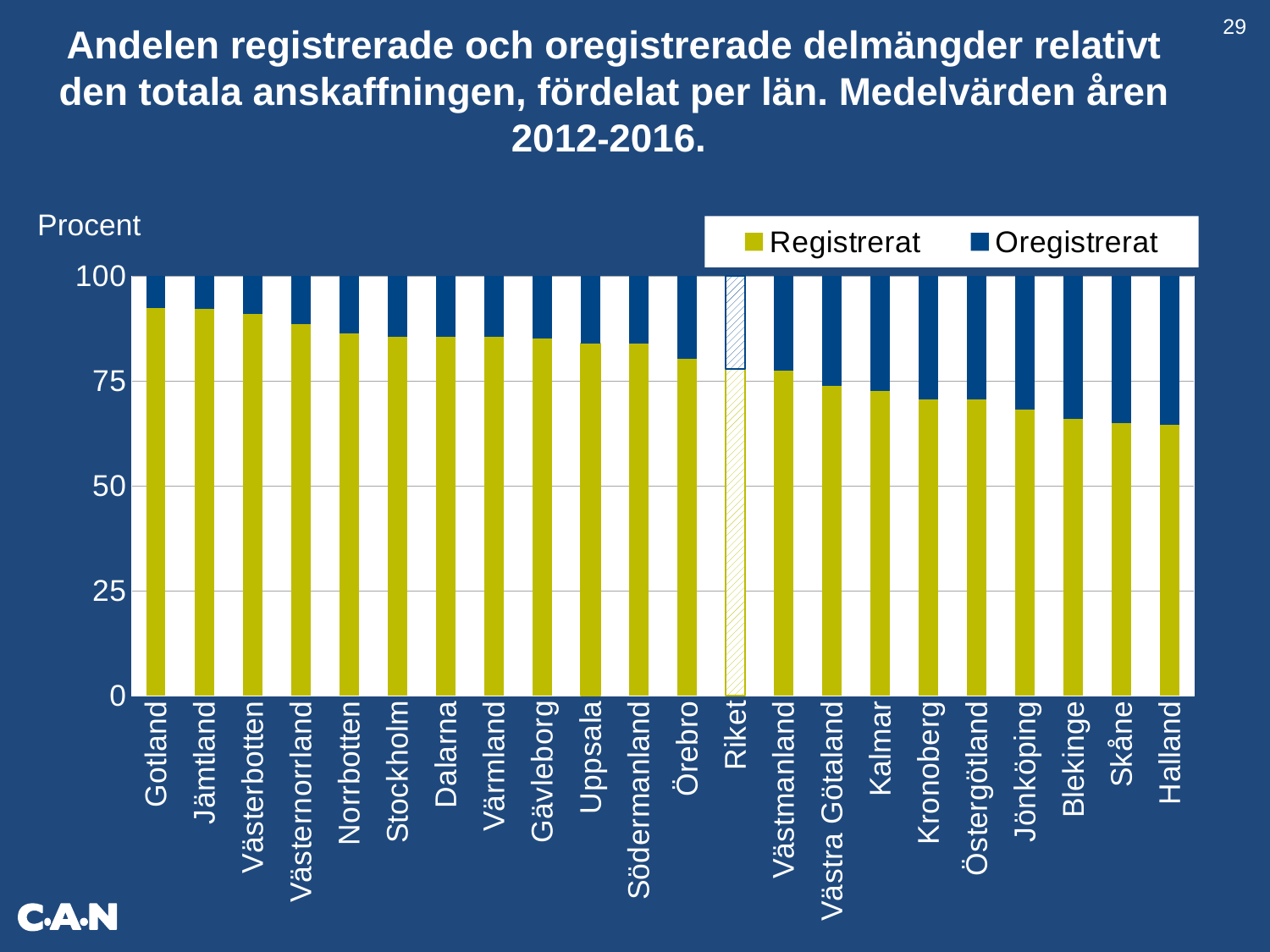
What is the label on the y axis? Procent Is the Registrerat value for Jönköping greater or less than 75? less Is the Oregistrerat value for Stockholm greater or less than 25? less What kind of chart is shown on the slide? Stacked bar chart What are the two series named in the legend? Registrerat and Oregistrerat How many series does the legend list? 2 Which has the larger Registrerat value, Gotland or Halland? Gotland How many categories are shown along the x axis? 22 Do the Registrerat values rise or fall from left to right along the x axis? fall Which has the larger Oregistrerat value, Skåne or Norrbotten? Skåne Is the Registrerat value for Gotland greater or less than 75? greater